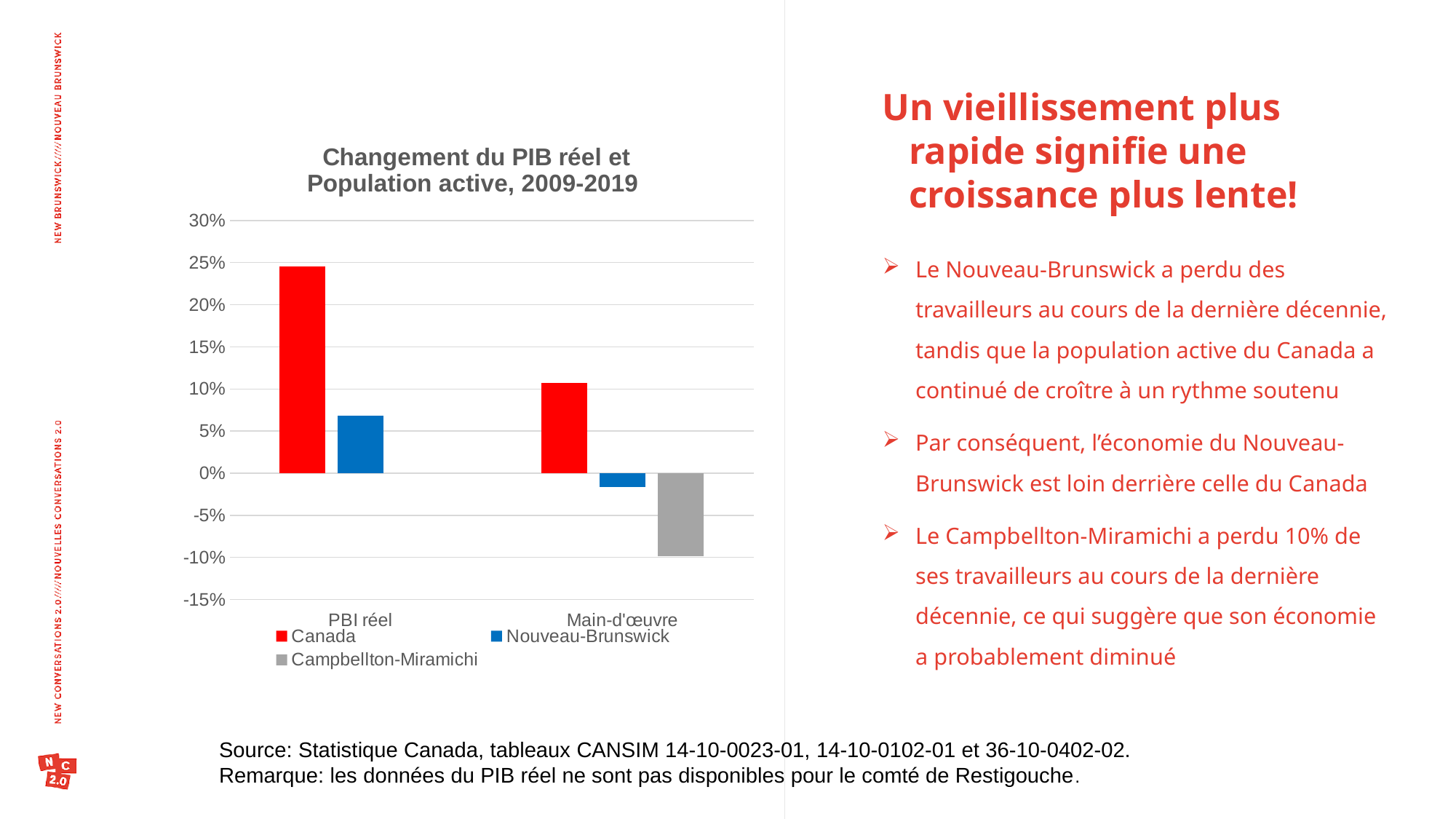
For Canada, is the value for PBI réel larger or smaller than the value for Main-d'œuvre? larger Is the value for Campbellton-Miramichi in Main-d'œuvre greater or less than -5%? less What is the title of the chart? Changement du PIB réel et Population active, 2009-2019 How many series does the legend of the chart list? 3 What kind of chart is shown on the slide? bar chart Is the value for Nouveau-Brunswick in PBI réel greater or less than 10%? less Which series has the lowest value for Main-d'œuvre? Campbellton-Miramichi Is the value for Canada in PBI réel greater or less than 20%? greater For Main-d'œuvre, which is larger: the value for Canada or the value for Nouveau-Brunswick? Canada Which series is shown in grey in the chart? Campbellton-Miramichi Which series has the highest value for PBI réel? Canada How many categories are shown on the x axis of the chart? 2